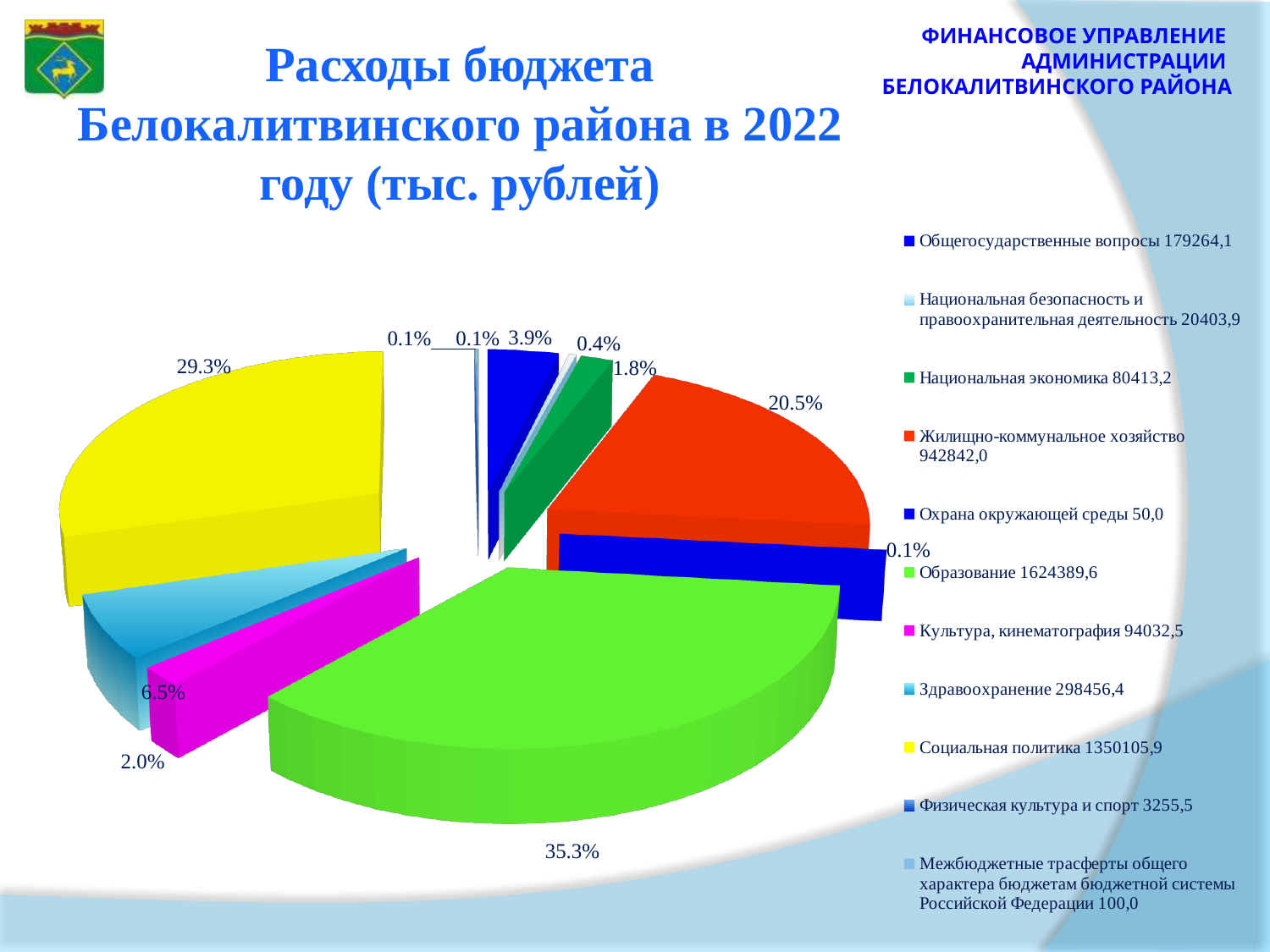
How many categories does the legend list? 11 What kind of chart is shown on the slide? Pie chart Which category has the smallest value listed in the legend? Охрана окружающей среды What percentage is shown for Жилищно-коммунальное хозяйство? 20.5% Which category has the largest slice of the pie? Образование What value does the legend give for Культура, кинематография? 94032,5 Which is larger, the share for Социальная политика or for Жилищно-коммунальное хозяйство? Социальная политика What percentage is shown for Здравоохранение? 6.5% What value (тыс. рублей) does the legend give for Образование? 1624389,6 By how many percentage points does the share of Образование exceed the share of Социальная политика? 6.0 percentage points What share of the pie does Образование account for? 35.3% What share of the pie does Социальная политика account for? 29.3%